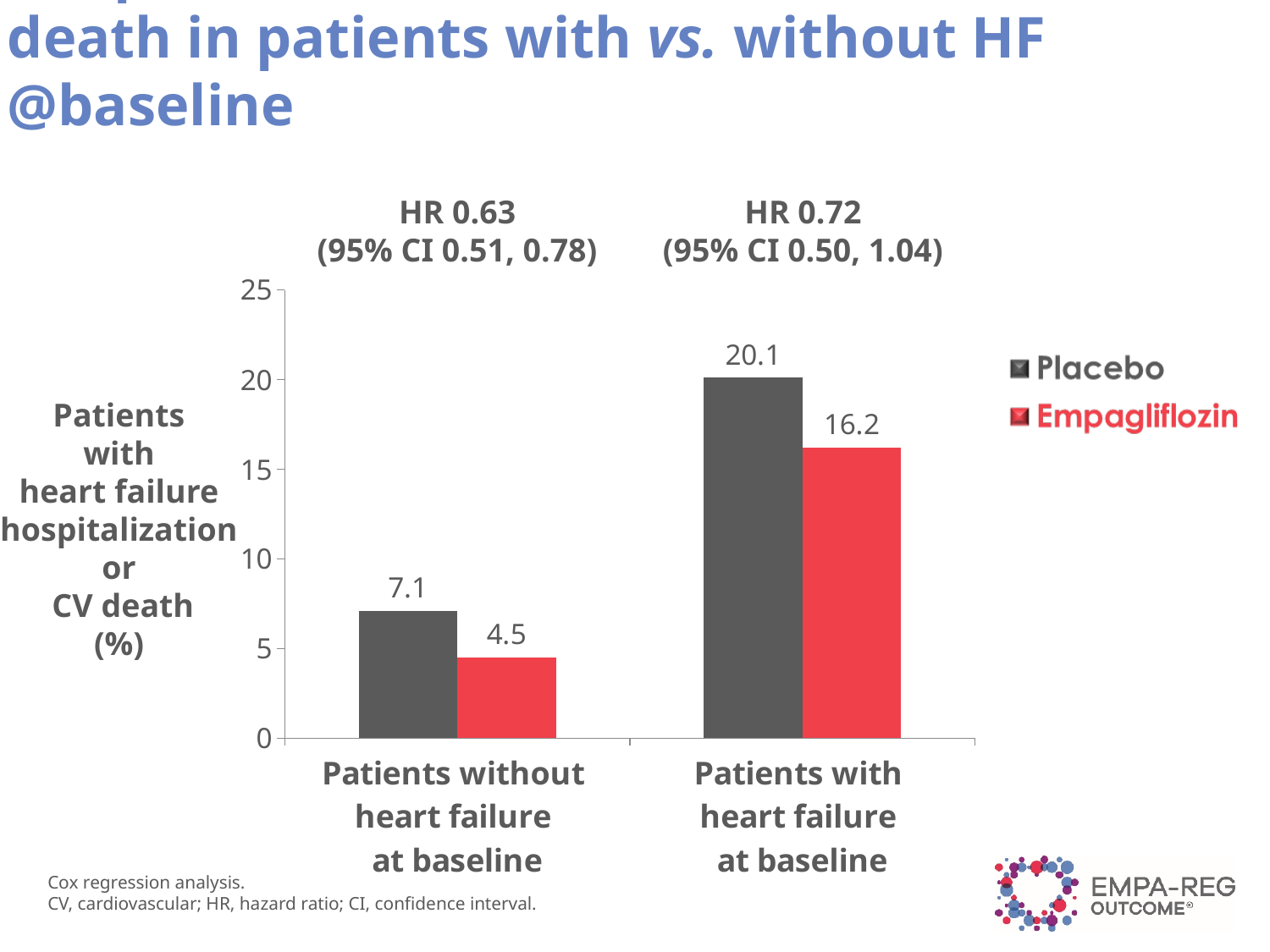
Which bar has the lowest value on the chart? Empagliflozin, patients without heart failure at baseline What is the value for Empagliflozin among patients without heart failure at baseline? 4.5 What is the difference between Placebo and Empagliflozin among patients with heart failure at baseline? 3.9 What is the value for Placebo among patients without heart failure at baseline? 7.1 What is the hazard ratio shown above the patients with heart failure at baseline group? HR 0.72 What is the value for Empagliflozin among patients with heart failure at baseline? 16.2 What is the value for Placebo among patients with heart failure at baseline? 20.1 What is the difference between Placebo and Empagliflozin among patients without heart failure at baseline? 2.6 How many series does the legend list? 2 Which is larger among patients without heart failure at baseline: Placebo or Empagliflozin? Placebo Which bar has the highest value on the chart? Placebo, patients with heart failure at baseline What kind of chart is shown on the slide? Bar chart